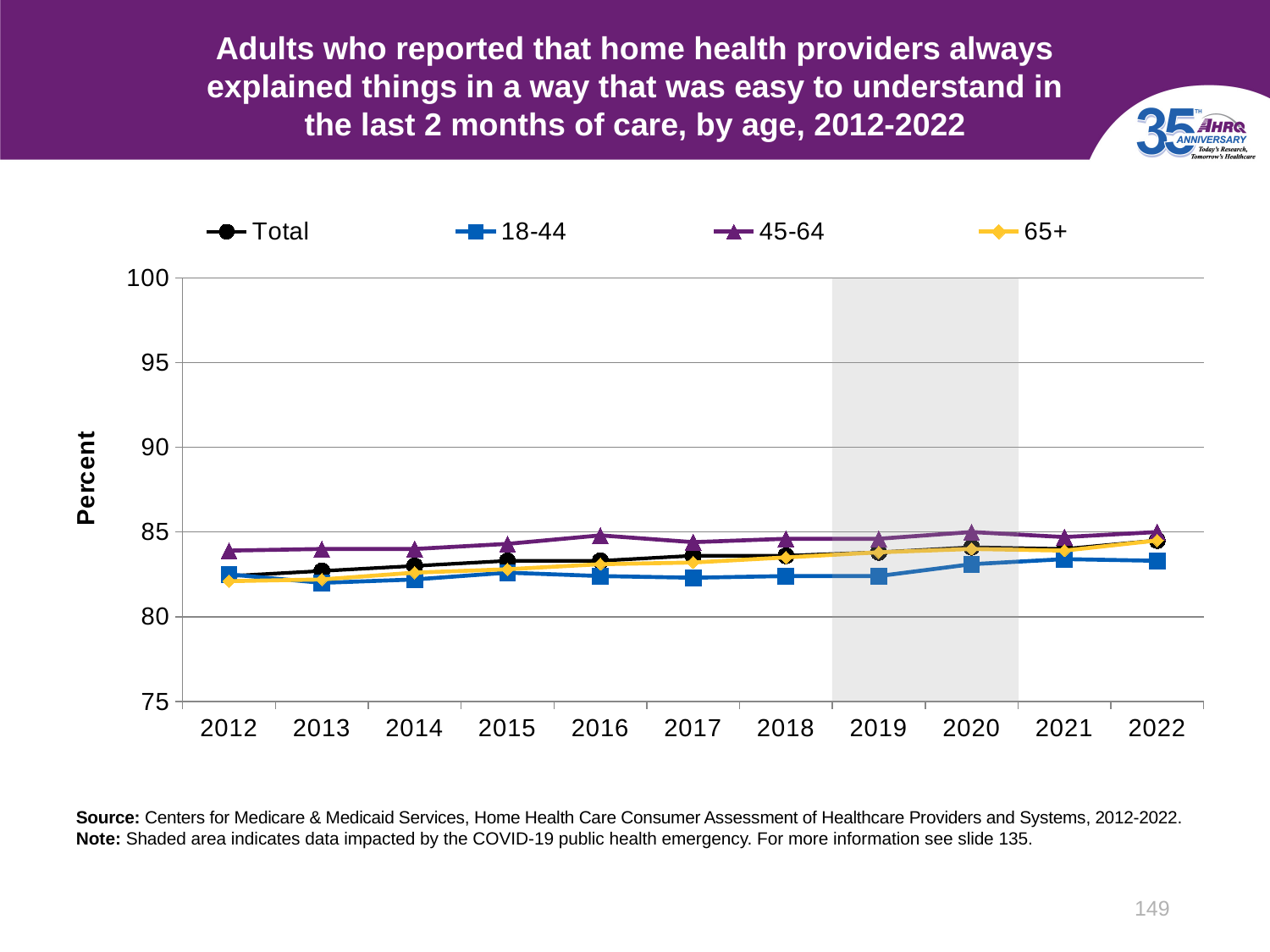
According to the note, what does the shaded area indicate? Data impacted by the COVID-19 public health emergency What kind of chart is shown on the slide? Line chart How many years are plotted along the x axis? 11 How many series does the legend list? 4 Is the value for 45-64 in 2012 greater or less than 80? greater Which age group has the highest value in 2013? 45-64 In 2016, which is larger: the value for 45-64 or the value for 18-44? 45-64 Does the Total line rise or fall overall from 2012 to 2022? rise Which age group has the lowest value in 2017? 18-44 What is the label on the y axis? Percent Is the value for 18-44 in 2013 greater or less than 85? less